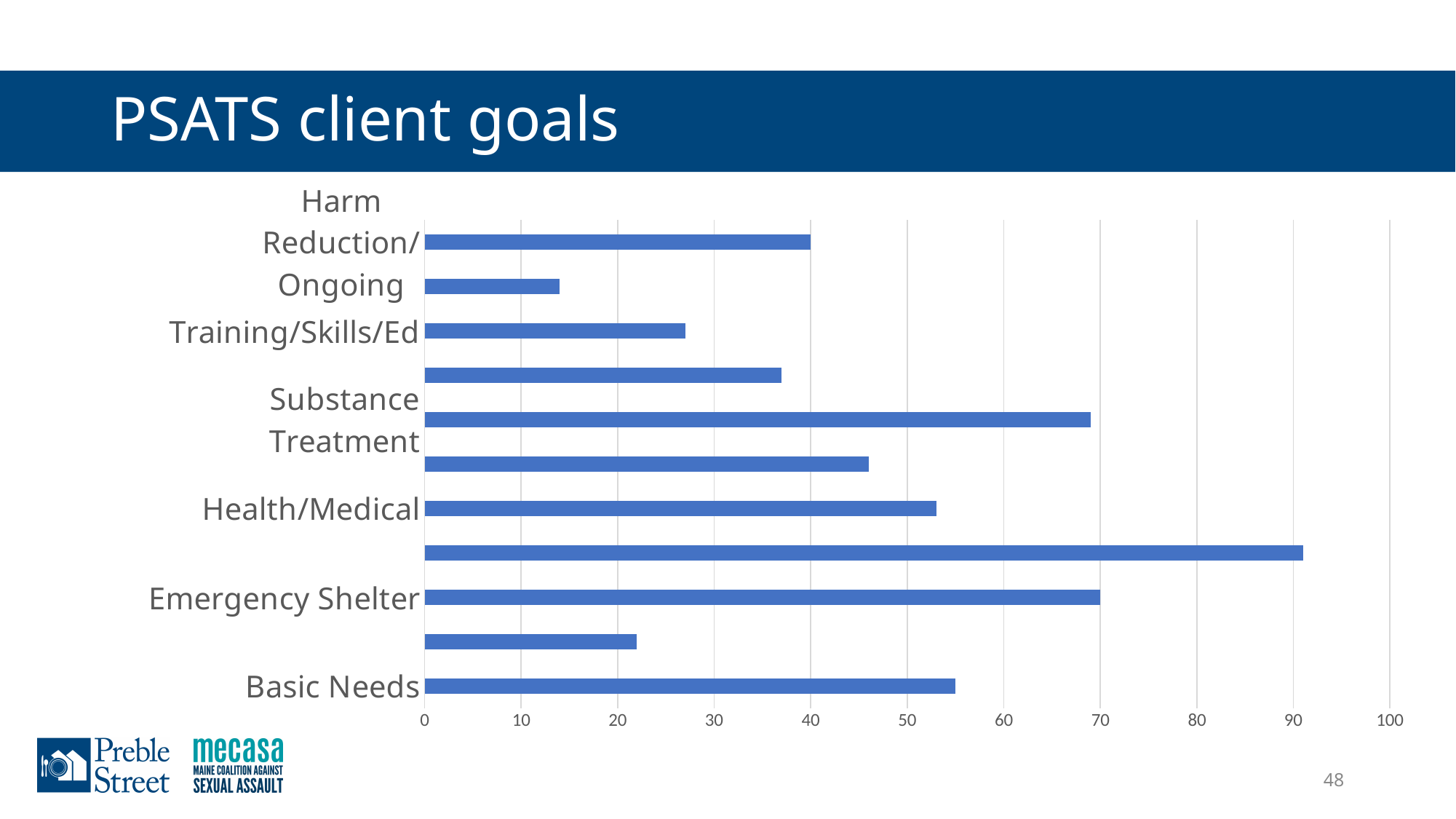
Which is larger, the value for Emergency Shelter or the value for Basic Needs? Emergency Shelter What kind of chart is shown on the slide? bar chart What is the title of the slide containing the chart? PSATS client goals How many bars are plotted in the chart? 11 Which is larger, the value for Substance Treatment or the value for Training/Skills/Ed? Substance Treatment Is the value for Health/Medical greater or less than 50? greater Is the value for Training/Skills/Ed greater or less than 30? less Is the value for Emergency Shelter greater or less than 60? greater What is the highest value shown on the horizontal axis of the chart? 100